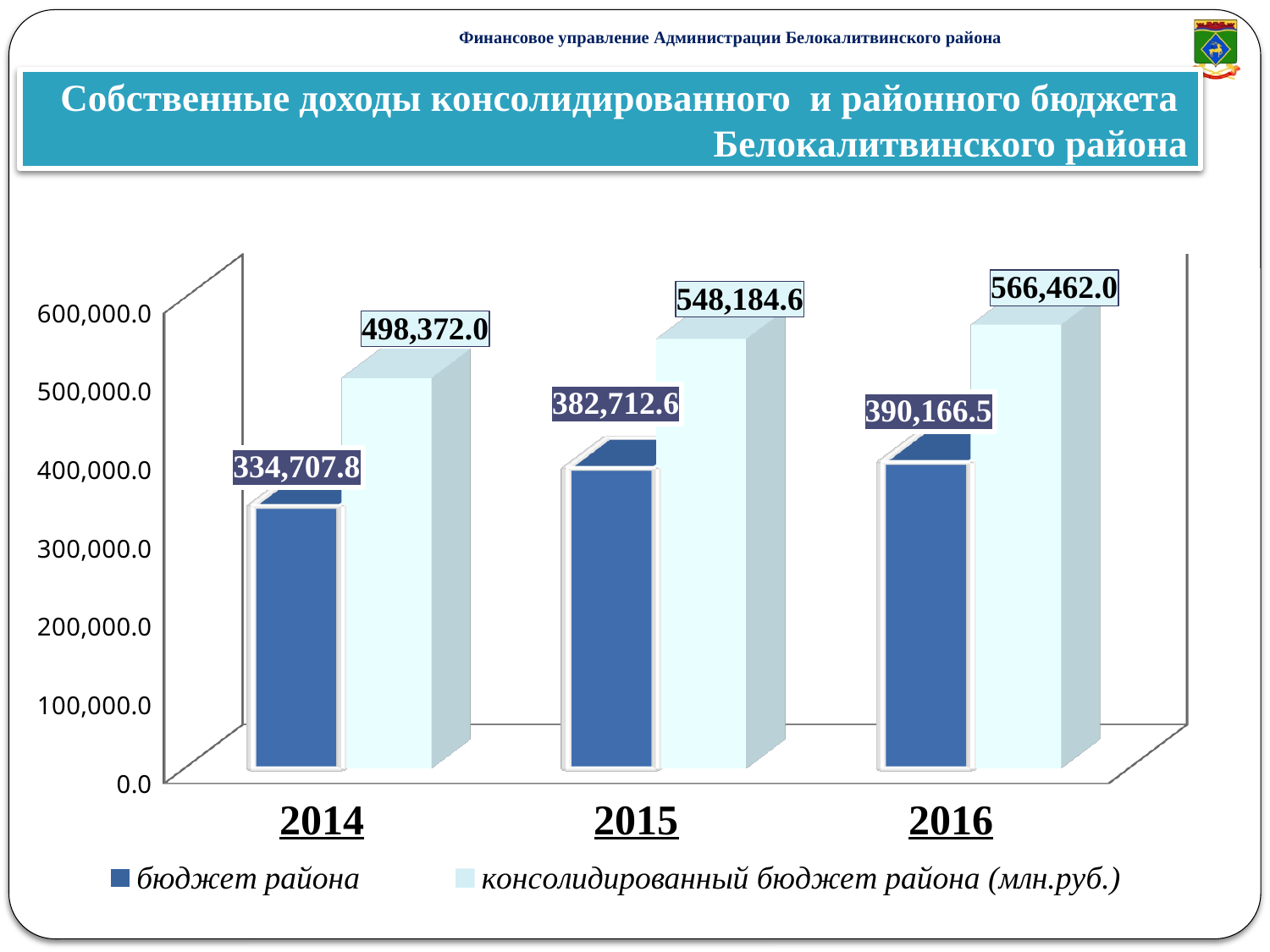
Which is larger: бюджет района in 2015 or бюджет района in 2016? бюджет района in 2016 What is the value for бюджет района in 2014? 334,707.8 What is the difference between консолидированный бюджет района and бюджет района in 2016? 176,295.5 In which year is бюджет района lowest? 2014 What is the value for бюджет района in 2016? 390,166.5 Do the values for бюджет района rise or fall from 2014 to 2016? rise What is the value for консолидированный бюджет района in 2015? 548,184.6 What is the value for консолидированный бюджет района in 2014? 498,372.0 How many series does the legend list? 2 In which year is консолидированный бюджет района highest? 2016 By how much did консолидированный бюджет района increase from 2014 to 2015? 49,812.6 How many years are shown on the x axis? 3